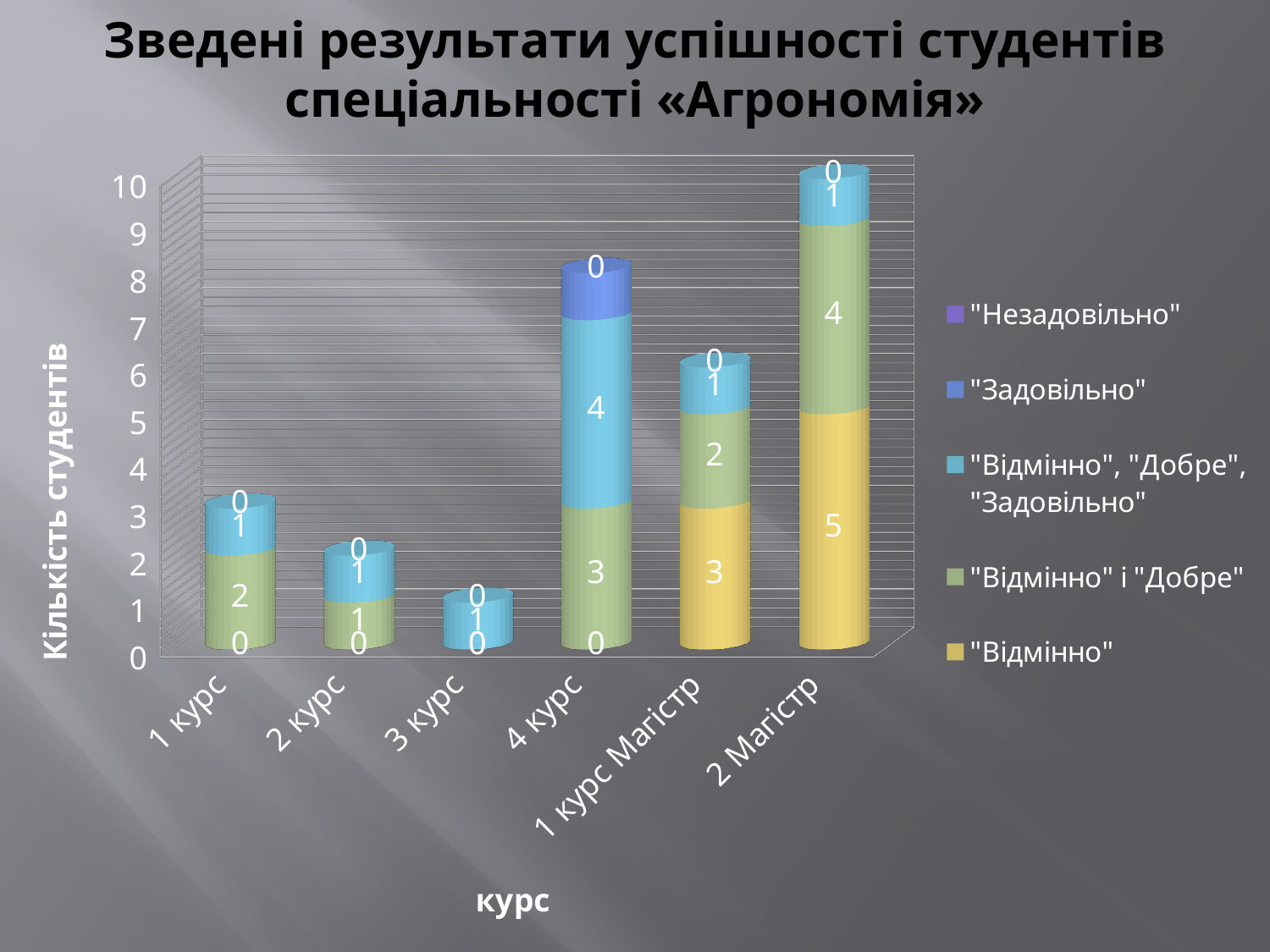
What is the difference between the "Відмінно" values for 2 Магістр and 1 курс Магістр? 2 What is the value of "Відмінно" for 2 Магістр? 5 What is the total of the stacked bar for 2 Магістр? 10 What is the value of "Відмінно" і "Добре" for 4 курс? 3 What is the value of "Відмінно" for 1 курс Магістр? 3 How many categories are shown on the x axis? 6 Which has a larger "Відмінно" і "Добре" value, 2 Магістр or 4 курс? 2 Магістр Which category has the tallest stacked bar? 2 Магістр What is the value of "Відмінно" і "Добре" for 1 курс? 2 Which category has the shortest stacked bar? 3 курс What is the total of the stacked bar for 1 курс Магістр? 6 How many series does the legend list? 5